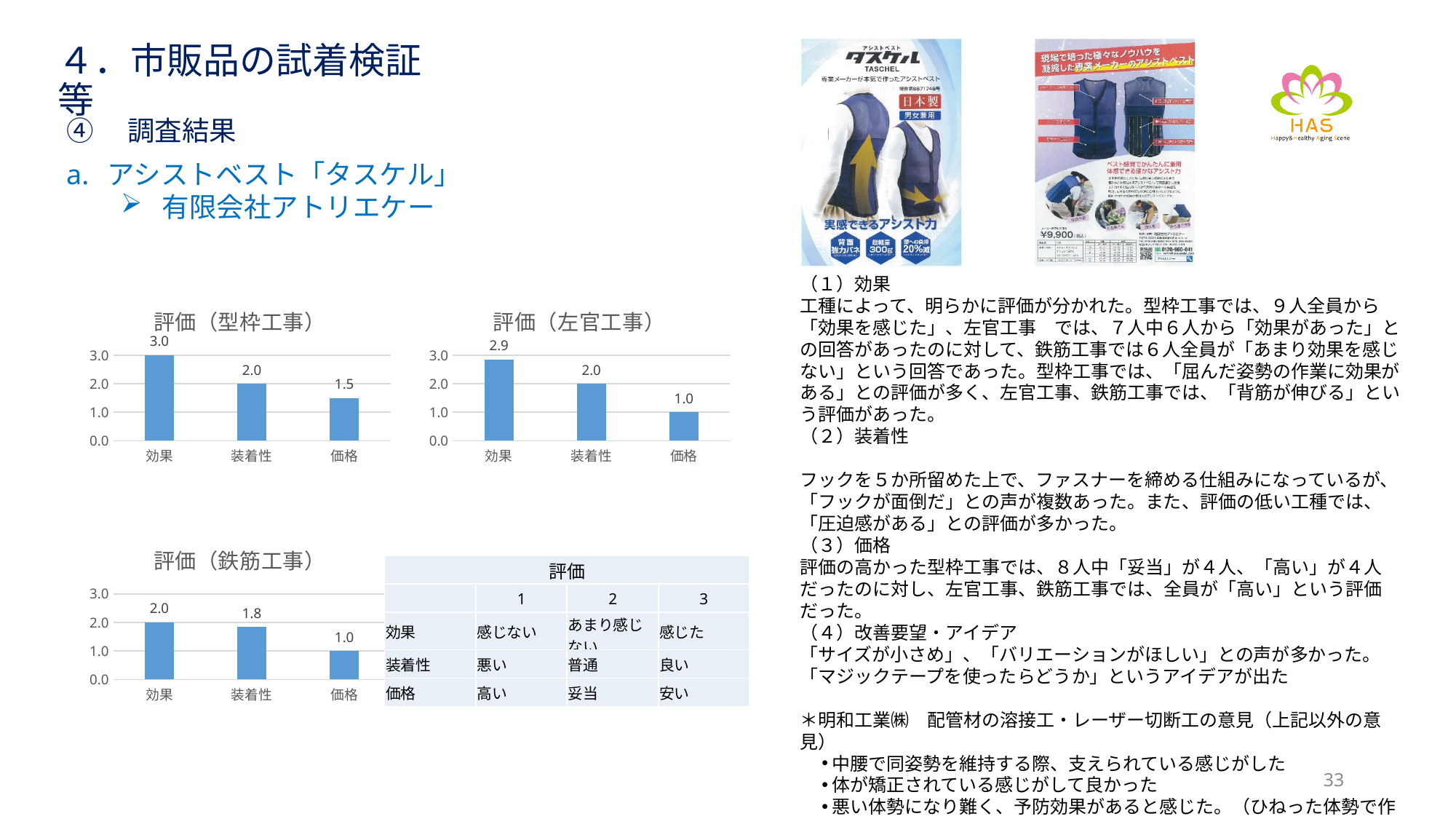
In the chart titled 評価（左官工事）, which category has the lowest value? 価格 In the chart titled 評価（型枠工事）, what is the value for 価格? 1.5 In the chart titled 評価（左官工事）, what is the value for 効果? 2.9 How many categories are shown in the chart titled 評価（左官工事）? 3 What kind of chart is the chart titled 評価（鉄筋工事）? Bar chart Which is larger: the value for 効果 in the chart titled 評価（型枠工事） or the value for 効果 in the chart titled 評価（鉄筋工事）? 評価（型枠工事） In the chart titled 評価（鉄筋工事）, what is the difference between the values for 効果 and 価格? 1.0 In the chart titled 評価（型枠工事）, which category has the highest value? 効果 In the chart titled 評価（鉄筋工事）, what is the value for 装着性? 1.8 In the chart titled 評価（型枠工事）, what is the value for 効果? 3.0 In the chart titled 評価（型枠工事）, what is the difference between the values for 効果 and 価格? 1.5 In the chart titled 評価（左官工事）, do the values rise or fall from left to right along the x axis? Fall